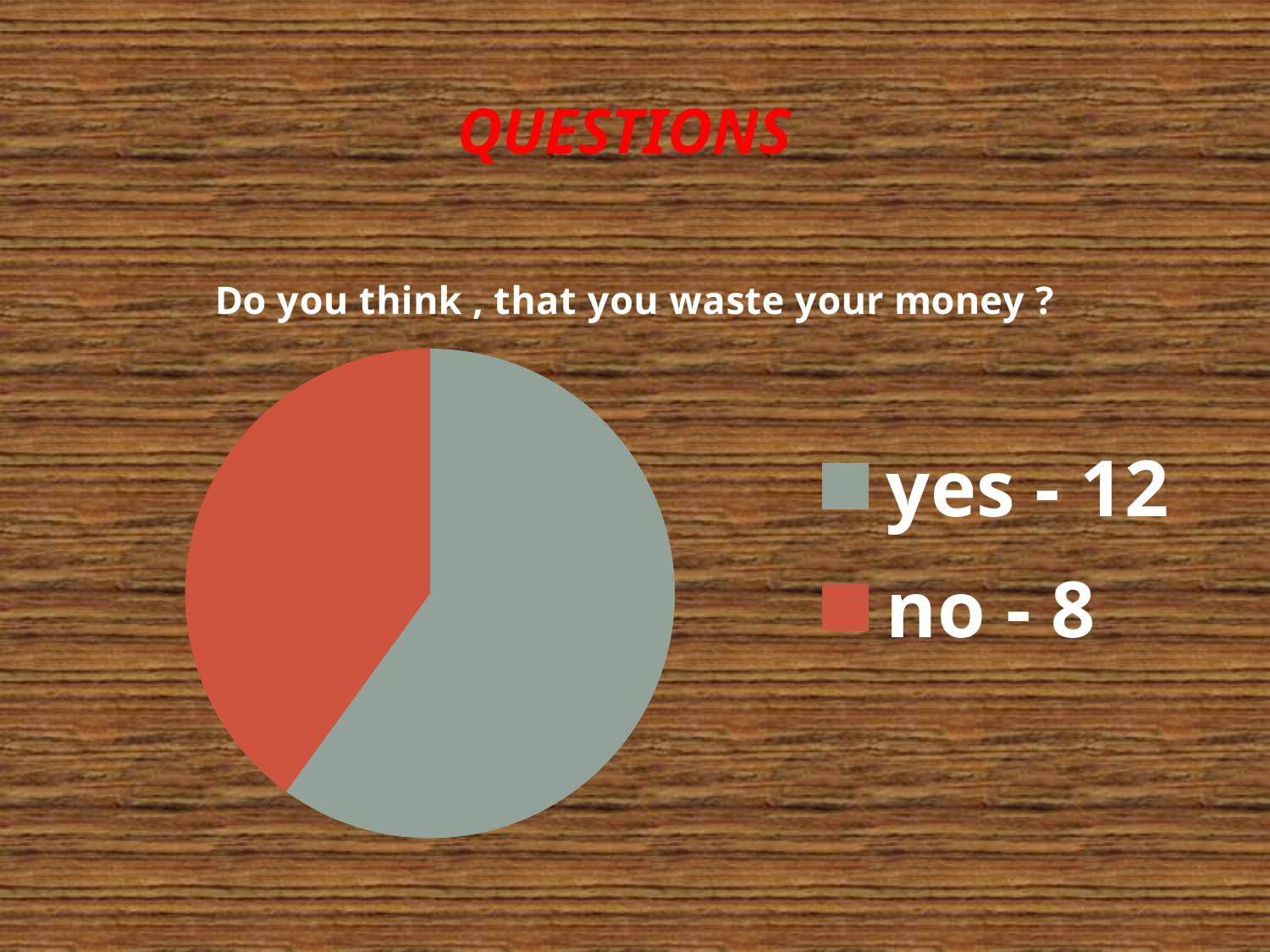
How many entries does the legend list? 2 How many slices does the pie chart have? 2 Which answer has the larger slice, yes or no? yes Which answer has the smallest slice of the pie? no How many people answered "yes" according to the legend? 12 What share of the pie does the "yes" slice represent? 60% How many people answered "no" according to the legend? 8 What is the difference between the number of "yes" and "no" answers? 4 What kind of chart is shown on the slide? pie chart What is the total number of responses shown in the pie chart? 20 Which answer has the largest slice of the pie? yes What question does the pie chart summarise? Do you think , that you waste your money ?